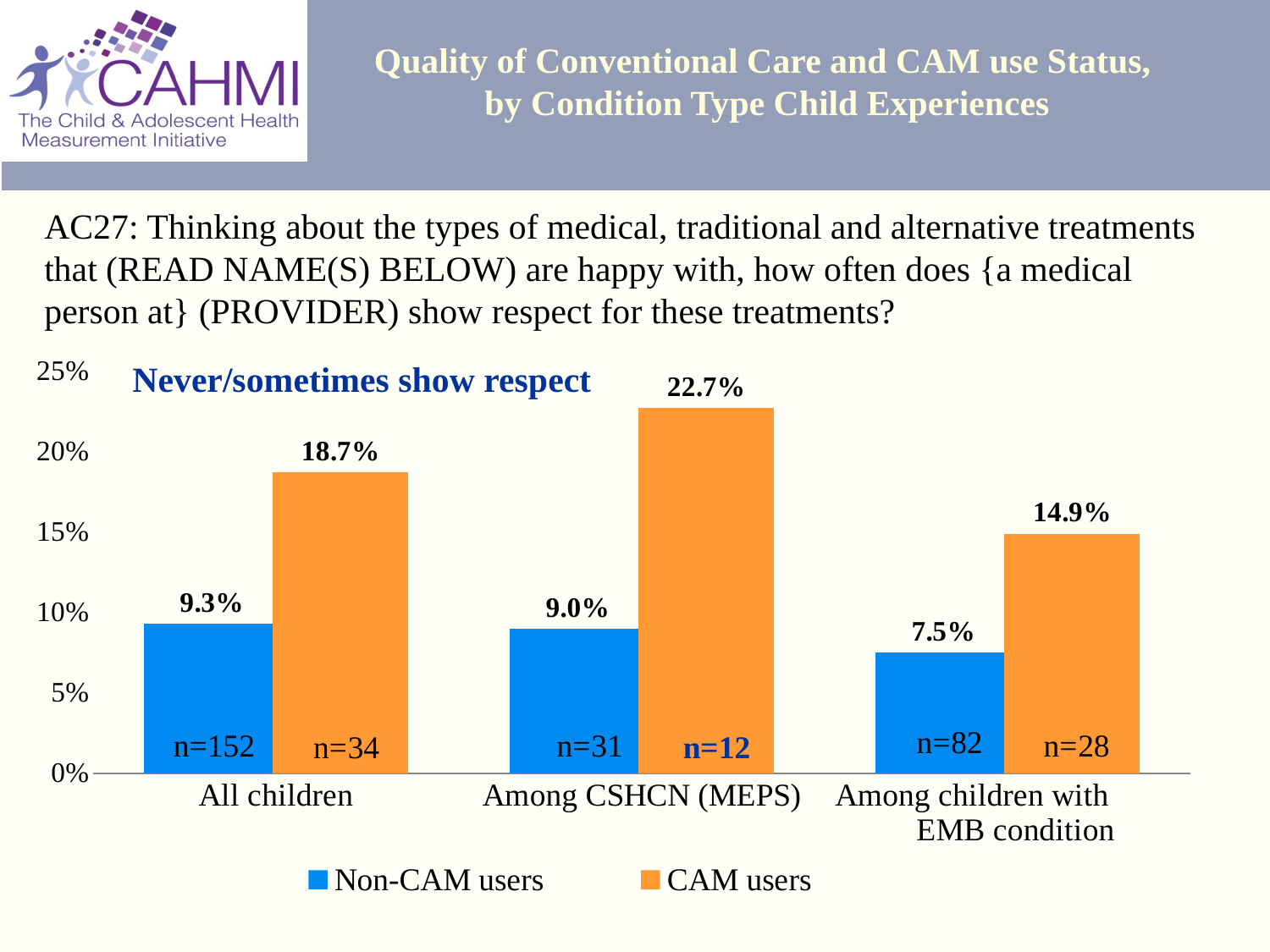
What is the value for Non-CAM users among children with EMB condition? 7.5% What kind of chart is shown on the slide? Bar chart Which group has the lowest value for Non-CAM users? Among children with EMB condition Is the value for CAM users among CSHCN (MEPS) greater or less than 20%? greater What is the sample size (n) shown for CAM users among CSHCN (MEPS)? n=12 Which is larger among children with EMB condition: the value for CAM users or for Non-CAM users? CAM users What is the difference between CAM users and Non-CAM users in the All children group? 9.4% What is the value for CAM users in the All children group? 18.7% Which group has the highest value for CAM users? Among CSHCN (MEPS) How many series does the legend list? 2 What is the value for CAM users among CSHCN (MEPS)? 22.7% How many groups are shown on the x axis? 3